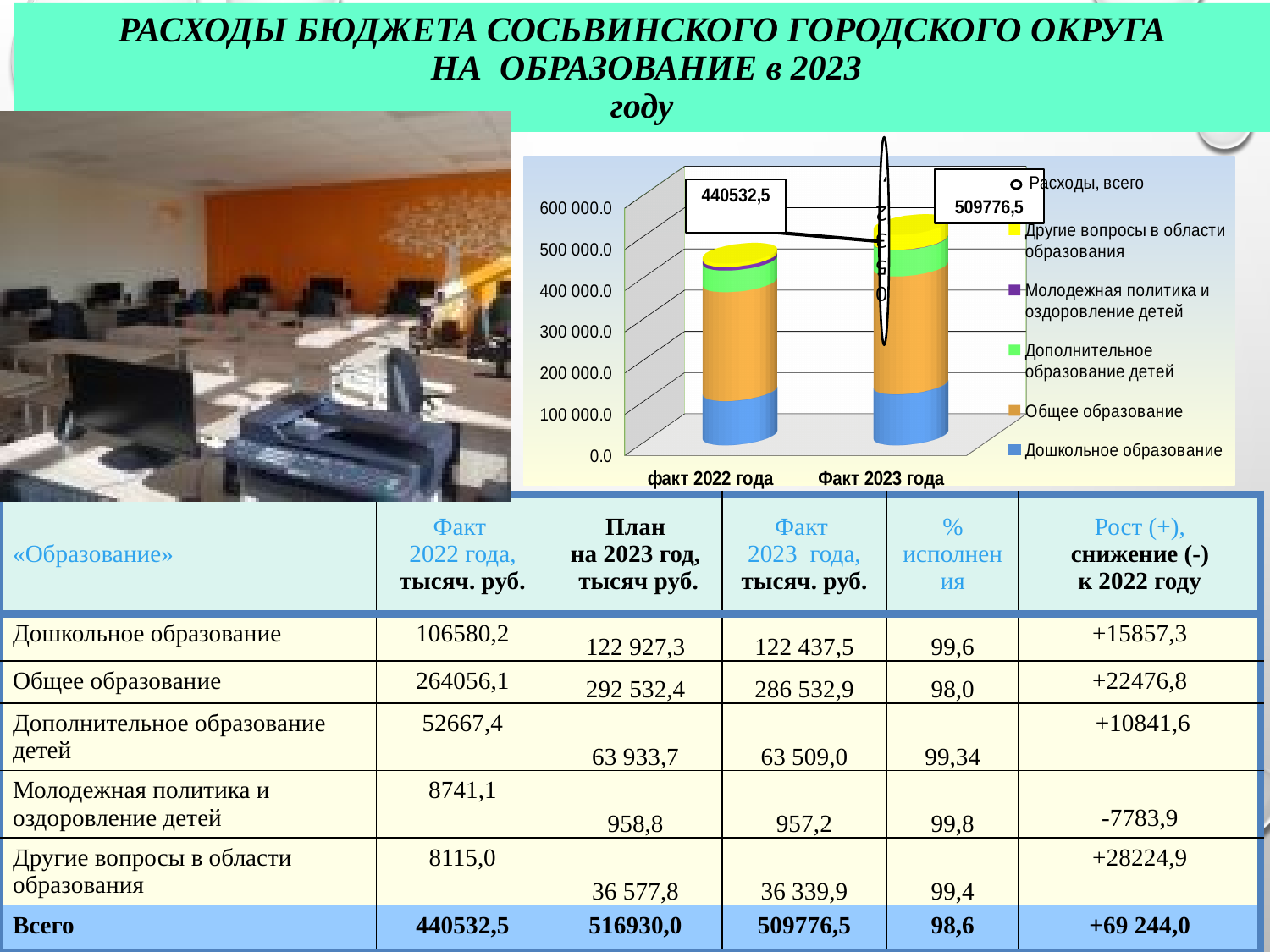
Which category has the higher total expenditure, факт 2022 года or Факт 2023 года? Факт 2023 года Is the total for факт 2022 года greater or less than 400 000.0? greater How many categories are shown on the x axis of the chart? 2 What is the total expenditure data label shown for факт 2022 года? 440532,5 Which category shows the lowest total expenditure? факт 2022 года Is the total for Факт 2023 года greater or less than 500 000.0? greater What kind of chart is shown on the slide? Stacked bar chart Do the total expenditures rise or fall from факт 2022 года to Факт 2023 года? Rise What is the total expenditure data label shown for Факт 2023 года? 509776,5 What is the difference between the total for Факт 2023 года and the total for факт 2022 года? 69244,0 What colour represents Дошкольное образование in the chart legend? Blue How many entries does the chart legend list? 6